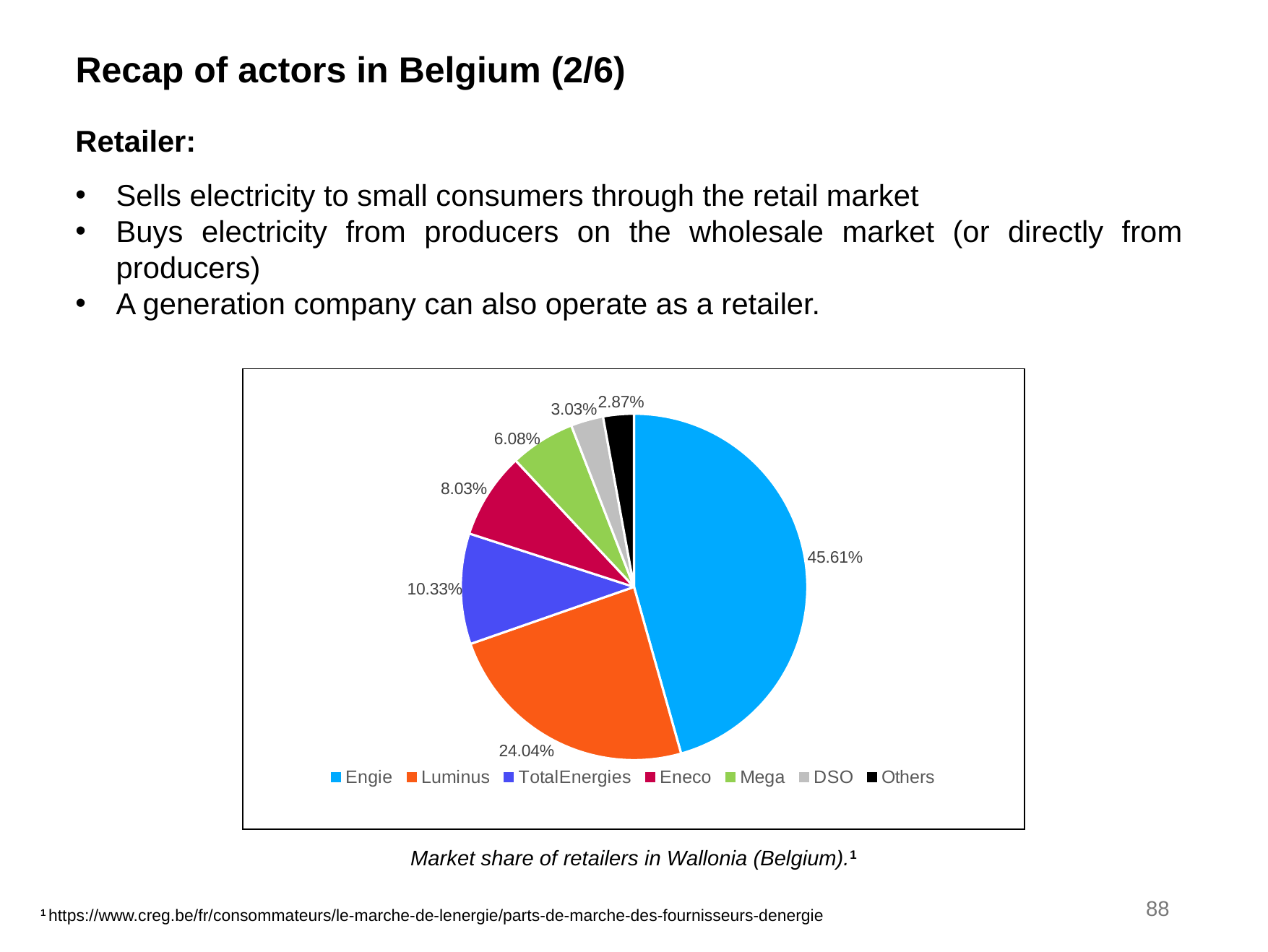
What is the market share of Eneco? 8.03% What kind of chart is shown on the slide? pie chart What is the difference between the market shares of Engie and Luminus? 21.57% What is the market share of TotalEnergies? 10.33% What is the market share of Luminus? 24.04% What is the market share of Engie? 45.61% Which category has the smallest share of the pie? Others What is the market share of Mega? 6.08% Which retailer has the largest market share? Engie Which has a larger market share, TotalEnergies or Eneco? TotalEnergies How many categories does the legend list? 7 What colour is the slice for Luminus? orange